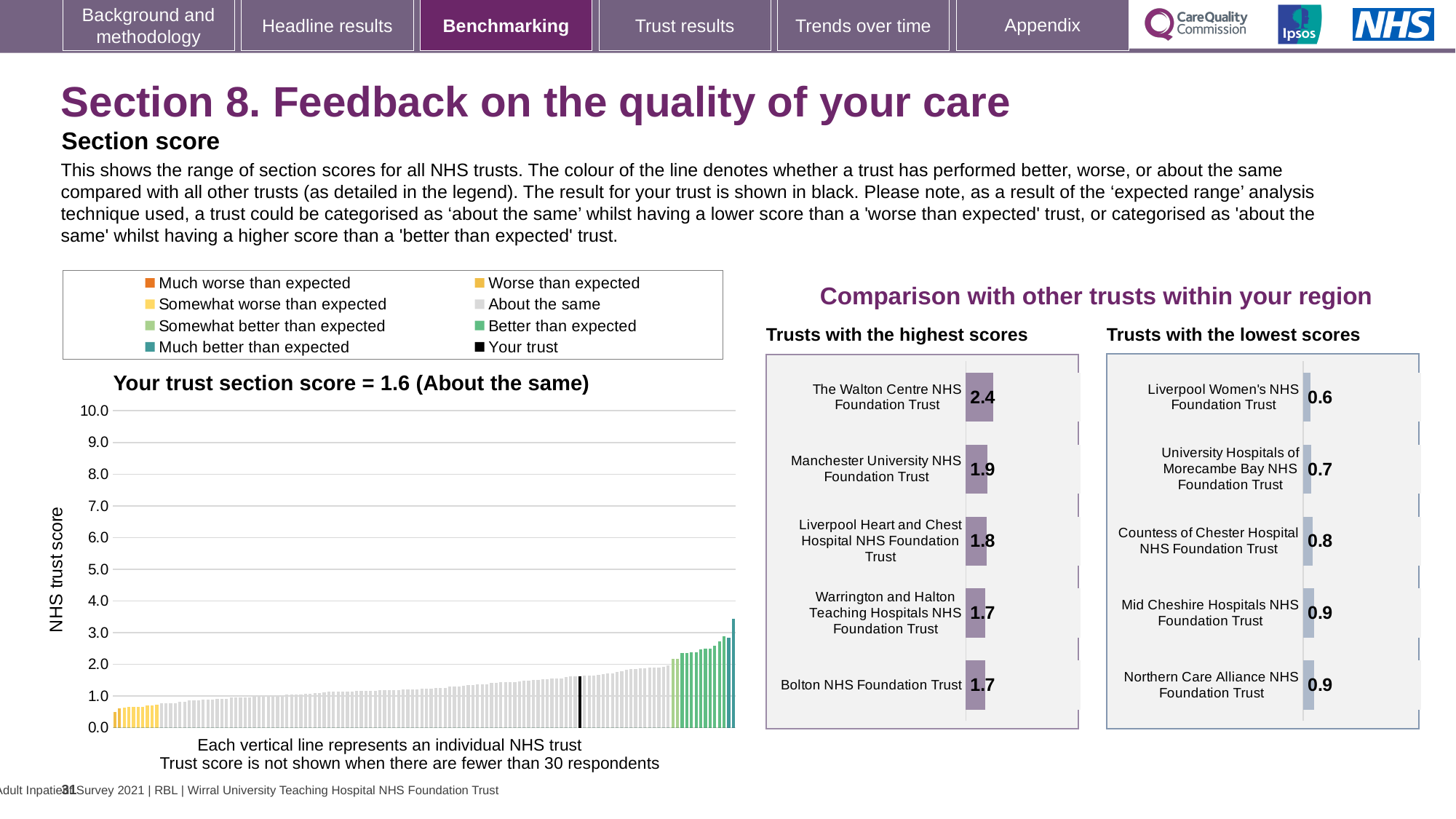
How many trusts are listed in the 'Trusts with the highest scores' chart? 5 According to the title of the main chart on the left, what is your trust's section score? 1.6 In the 'Trusts with the highest scores' chart, which trust has the highest score? The Walton Centre NHS Foundation Trust In the 'Trusts with the lowest scores' chart, which trust has the lowest score? Liverpool Women's NHS Foundation Trust In the 'Trusts with the lowest scores' chart, which has the larger score: University Hospitals of Morecambe Bay NHS Foundation Trust or Mid Cheshire Hospitals NHS Foundation Trust? Mid Cheshire Hospitals NHS Foundation Trust What kind of chart is the main chart on the left showing NHS trust scores? Bar chart In the 'Trusts with the highest scores' chart, what is the score for Manchester University NHS Foundation Trust? 1.9 How many entries does the legend above the main chart on the left list? 8 In the 'Trusts with the highest scores' chart, what is the score for The Walton Centre NHS Foundation Trust? 2.4 In the 'Trusts with the lowest scores' chart, what is the score for Liverpool Women's NHS Foundation Trust? 0.6 In the 'Trusts with the lowest scores' chart, what is the score for Countess of Chester Hospital NHS Foundation Trust? 0.8 In the 'Trusts with the highest scores' chart, what is the difference between the scores of The Walton Centre NHS Foundation Trust and Manchester University NHS Foundation Trust? 0.5